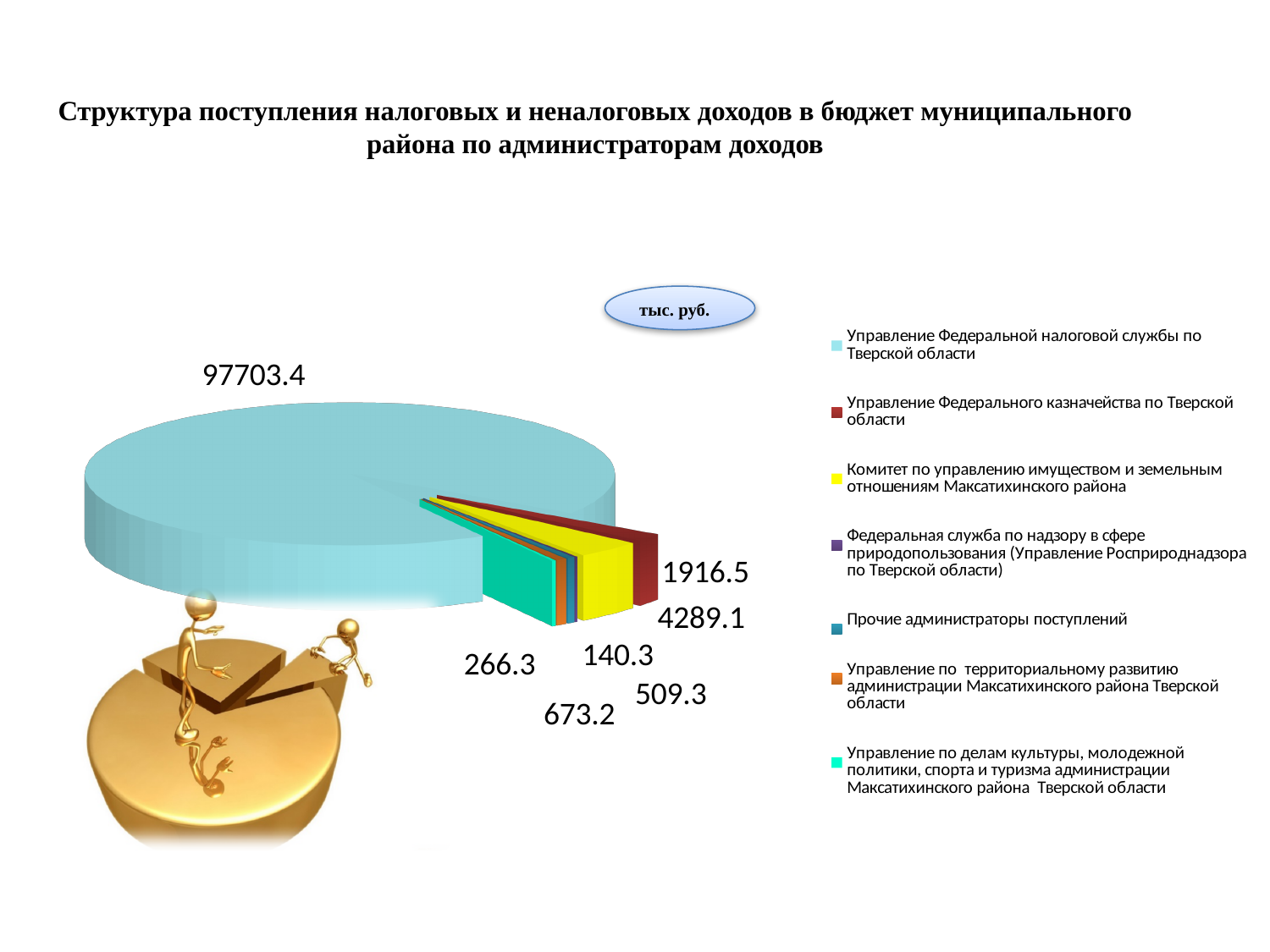
Which administrator has the largest share of the pie? Управление Федеральной налоговой службы по Тверской области How many entries does the legend list? 7 What is the difference between the values for Комитет по управлению имуществом и земельным отношениям and Управление Федерального казначейства? 2372.6 What is the smallest value printed on the chart? 140.3 What kind of chart is shown on the slide? pie chart What is the value for Управление Федерального казначейства по Тверской области? 1916.5 What is the value for Управление Федеральной налоговой службы по Тверской области? 97703.4 What is the value for Комитет по управлению имуществом и земельным отношениям Максатихинского района? 4289.1 What is the difference between the values for Управление Федеральной налоговой службы and Комитет по управлению имуществом и земельным отношениям? 93414.3 Which is larger: the value for Комитет по управлению имуществом и земельным отношениям or the value for Управление Федерального казначейства? Комитет по управлению имуществом и земельным отношениям In what units are the values on the chart given? тыс. руб. How many slices does the pie chart have? 7